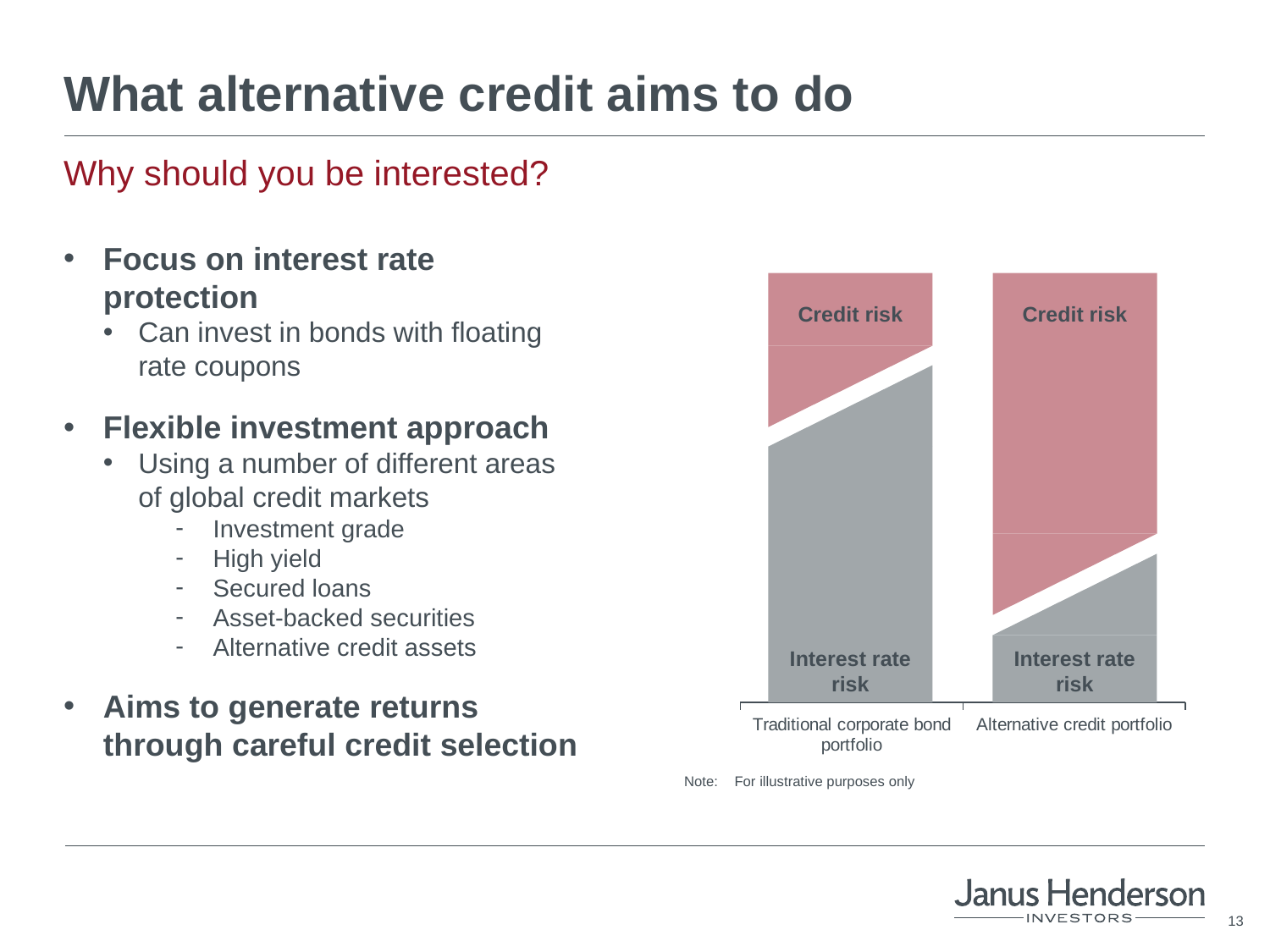
Which segment sits at the bottom of each stacked bar? Interest rate risk In the Alternative credit portfolio bar, which segment is larger, credit risk or interest rate risk? Credit risk Which colour represents interest rate risk in the chart? Grey In the Traditional corporate bond portfolio bar, which segment is larger, credit risk or interest rate risk? Interest rate risk Which portfolio has the larger credit risk segment? Alternative credit portfolio How many risk components are shown in each stacked bar? 2 What are the two categories labelled on the x axis of the chart? Traditional corporate bond portfolio; Alternative credit portfolio How many portfolios (categories) are shown on the x axis of the chart? 2 What kind of chart is shown on the right of the slide? Stacked bar chart